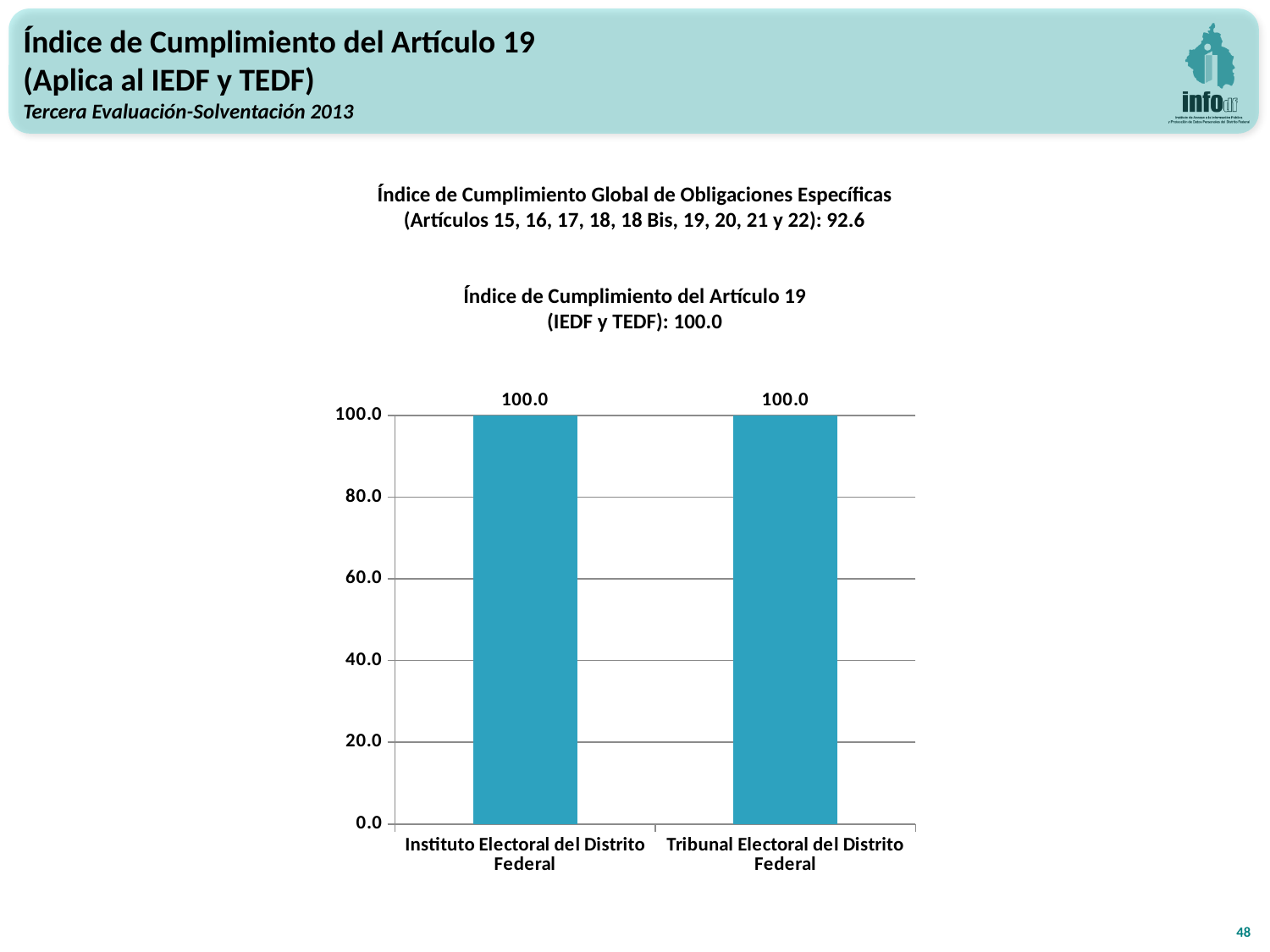
Is the value for Tribunal Electoral del Distrito Federal greater or less than 80.0? greater Do the values rise, fall or stay the same from Instituto Electoral del Distrito Federal to Tribunal Electoral del Distrito Federal? Stay the same What is the difference between the values for Instituto Electoral del Distrito Federal and Tribunal Electoral del Distrito Federal? 0.0 What is the title of the chart? Índice de Cumplimiento del Artículo 19 (IEDF y TEDF): 100.0 What is the highest value shown on the y axis of the chart? 100.0 How many categories are shown on the x axis of the chart? 2 What is the value for Instituto Electoral del Distrito Federal? 100.0 What kind of chart is shown on the slide? Bar chart Is the value for Instituto Electoral del Distrito Federal greater or less than 60.0? greater What is the value for Tribunal Electoral del Distrito Federal? 100.0